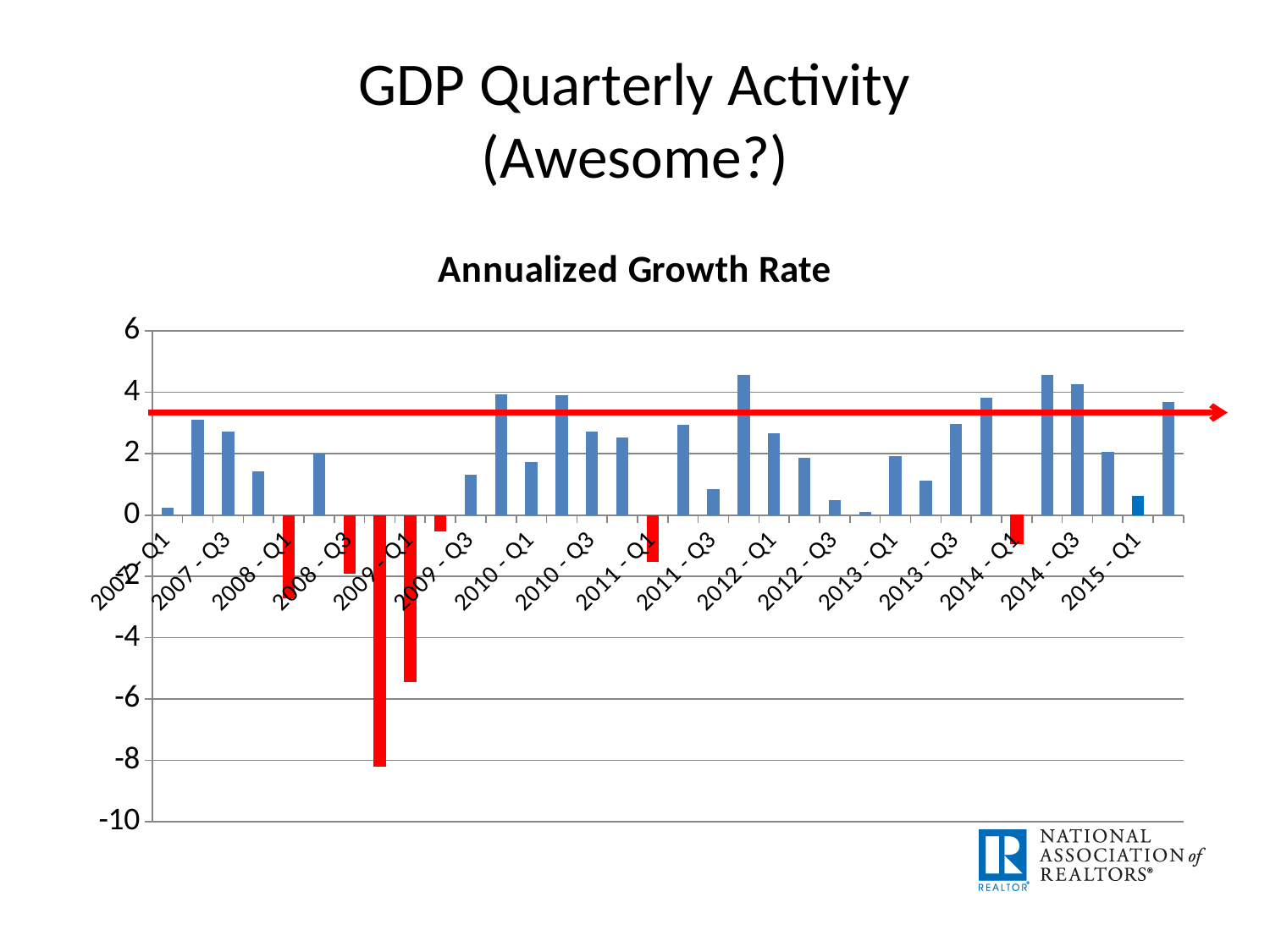
Is the value for 2009 - Q1 greater or less than -4? less Is the value for 2007 - Q3 greater or less than 2? greater Is the value for 2014 - Q3 greater or less than 4? greater Which is larger, the value for 2014 - Q3 or the value for 2015 - Q1? 2014 - Q3 What is the title of the chart? Annualized Growth Rate How many bars in the chart are red (negative)? 7 What kind of chart is shown on the slide? bar chart Which is larger, the value for 2007 - Q3 or the value for 2008 - Q1? 2007 - Q3 What colour are the bars with negative values? red